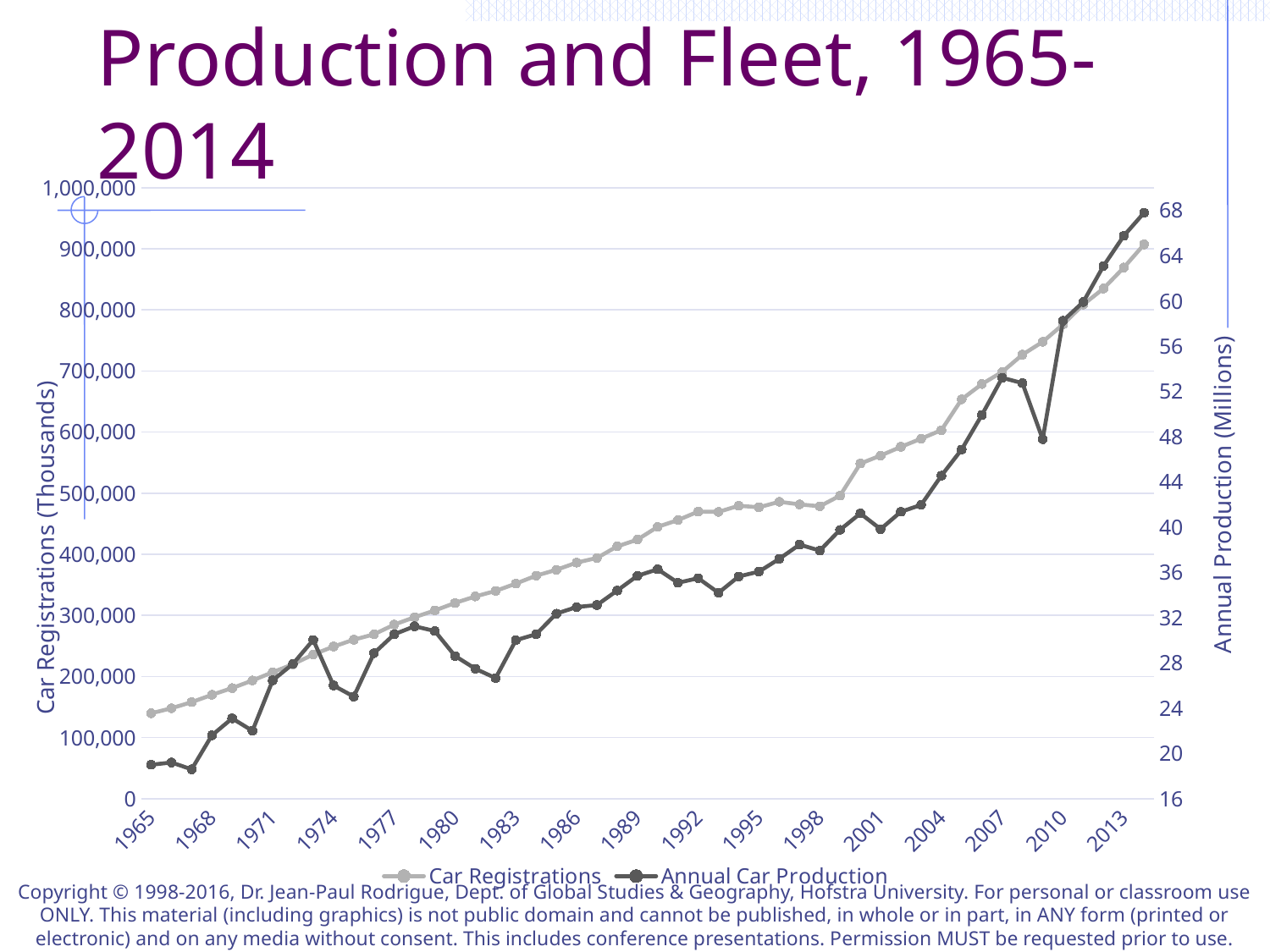
How many series does the legend list? 2 Do Car Registrations generally rise or fall from 1965 to 2014? Rise Is the value for Car Registrations in 2014 greater or less than 800,000? greater Is the value for Annual Car Production in 1965 greater or less than 20? less Is the value for Car Registrations in 1965 greater or less than 200,000? less In which year are Car Registrations highest? 2014 In which year are Car Registrations lowest? 1965 What is the label of the right-hand vertical axis? Annual Production (Millions) What are the two series named in the legend? Car Registrations and Annual Car Production In which year is Annual Car Production highest? 2014 What kind of chart is shown on the slide? Line chart